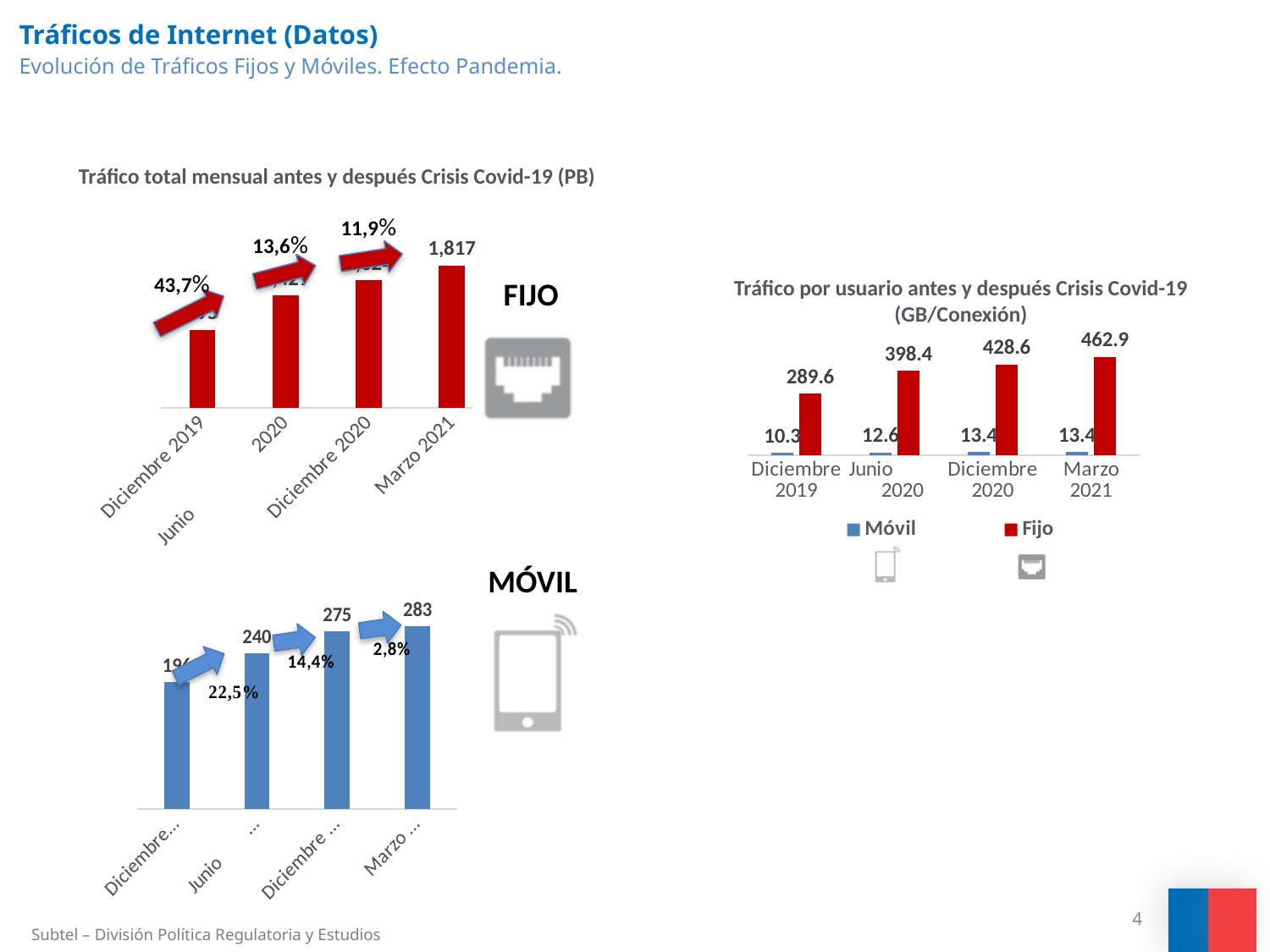
How many series does the legend of the chart 'Tráfico por usuario antes y después Crisis Covid-19 (GB/Conexión)' list? 2 In the chart 'Tráfico por usuario antes y después Crisis Covid-19 (GB/Conexión)', what is the Fijo value for Marzo 2021? 462.9 In the chart 'Tráfico por usuario antes y después Crisis Covid-19 (GB/Conexión)', which is larger, the Fijo value for Junio 2020 or for Diciembre 2020? Diciembre 2020 In the chart 'Tráfico por usuario antes y después Crisis Covid-19 (GB/Conexión)', which period has the lowest Móvil value? Diciembre 2019 In the chart 'Tráfico por usuario antes y después Crisis Covid-19 (GB/Conexión)', which period has the highest Fijo value? Marzo 2021 In the FIJO chart 'Tráfico total mensual antes y después Crisis Covid-19 (PB)' at the top left, what is the value for Marzo 2021? 1,817 In the chart 'Tráfico por usuario antes y después Crisis Covid-19 (GB/Conexión)', what is the Móvil value for Diciembre 2019? 10.3 How many periods are shown on the x axis of the chart 'Tráfico por usuario antes y después Crisis Covid-19 (GB/Conexión)'? 4 In the chart 'Tráfico por usuario antes y después Crisis Covid-19 (GB/Conexión)', what is the difference between the Fijo values for Marzo 2021 and Diciembre 2019? 173.3 In the MÓVIL chart at the bottom left, what is the value of the last bar (Marzo)? 283 In the chart 'Tráfico por usuario antes y después Crisis Covid-19 (GB/Conexión)', do the Fijo values rise or fall from Diciembre 2019 to Marzo 2021? rise What kind of chart is the MÓVIL chart at the bottom left of the slide? bar chart